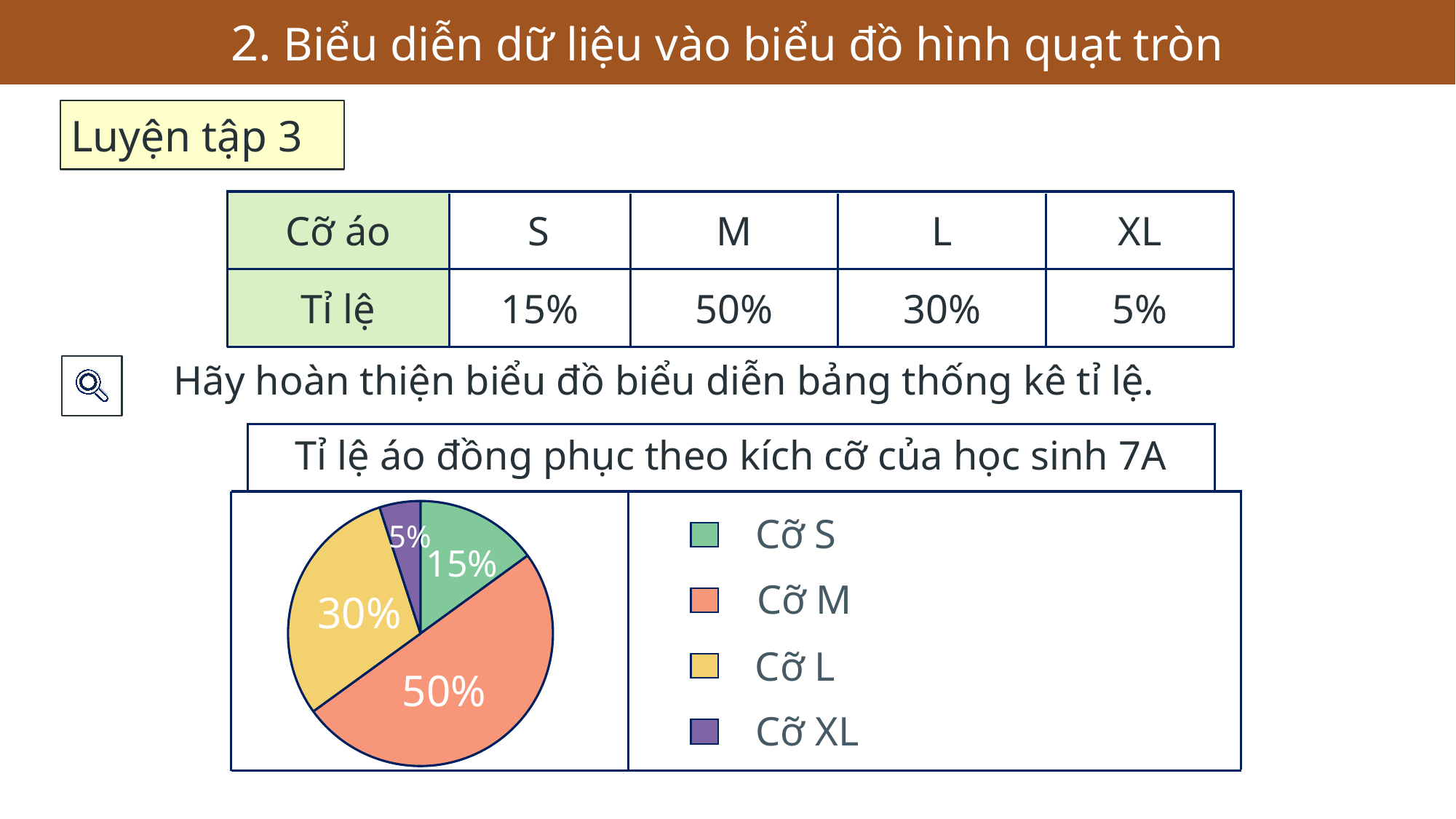
What is the difference in percentage points between the Cỡ L slice and the Cỡ S slice? 15 What percentage does the Cỡ M slice show? 50% How many slices does the pie chart have? 4 What kind of chart is shown on the slide? pie chart What percentage does the Cỡ L slice show? 30% What is the title of the pie chart? Tỉ lệ áo đồng phục theo kích cỡ của học sinh 7A Which size has the largest slice of the pie? Cỡ M Which slice is larger, Cỡ L or Cỡ XL? Cỡ L How many entries does the legend list? 4 What percentage does the Cỡ S slice show? 15% What percentage does the Cỡ XL slice show? 5% Which size has the smallest slice of the pie? Cỡ XL